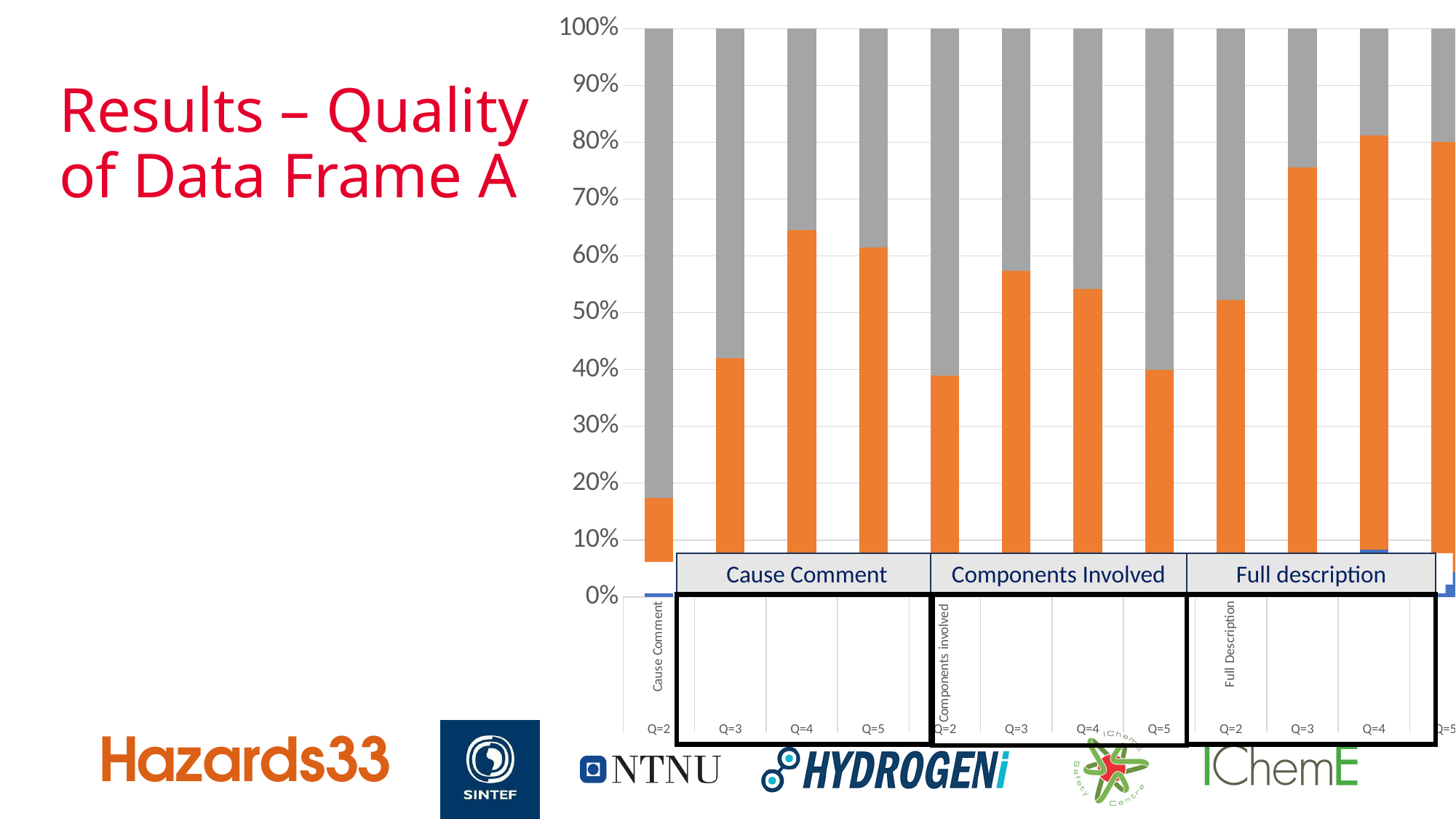
What kind of chart is shown on the slide? Stacked bar chart Is the top of the orange segment for Full description Q=3 greater or less than 70%? greater What are the three category groups labelled along the x axis? Cause Comment, Components Involved, Full description Within the Components Involved group, which bar has the larger orange segment, Q=3 or Q=5? Q=3 How many bars are plotted in the chart? 12 Within the Cause Comment group, which bar has the larger orange segment, Q=3 or Q=4? Q=4 Within the Cause Comment group, which bar has the smallest orange segment? Q=2 What colour is the topmost segment of each stacked bar? Grey Is the top of the orange segment for Cause Comment Q=2 greater or less than 20%? less Is the top of the orange segment for Full description Q=4 greater or less than 70%? greater Within the Full description group, does the orange segment rise or fall from Q=2 to Q=4? rise